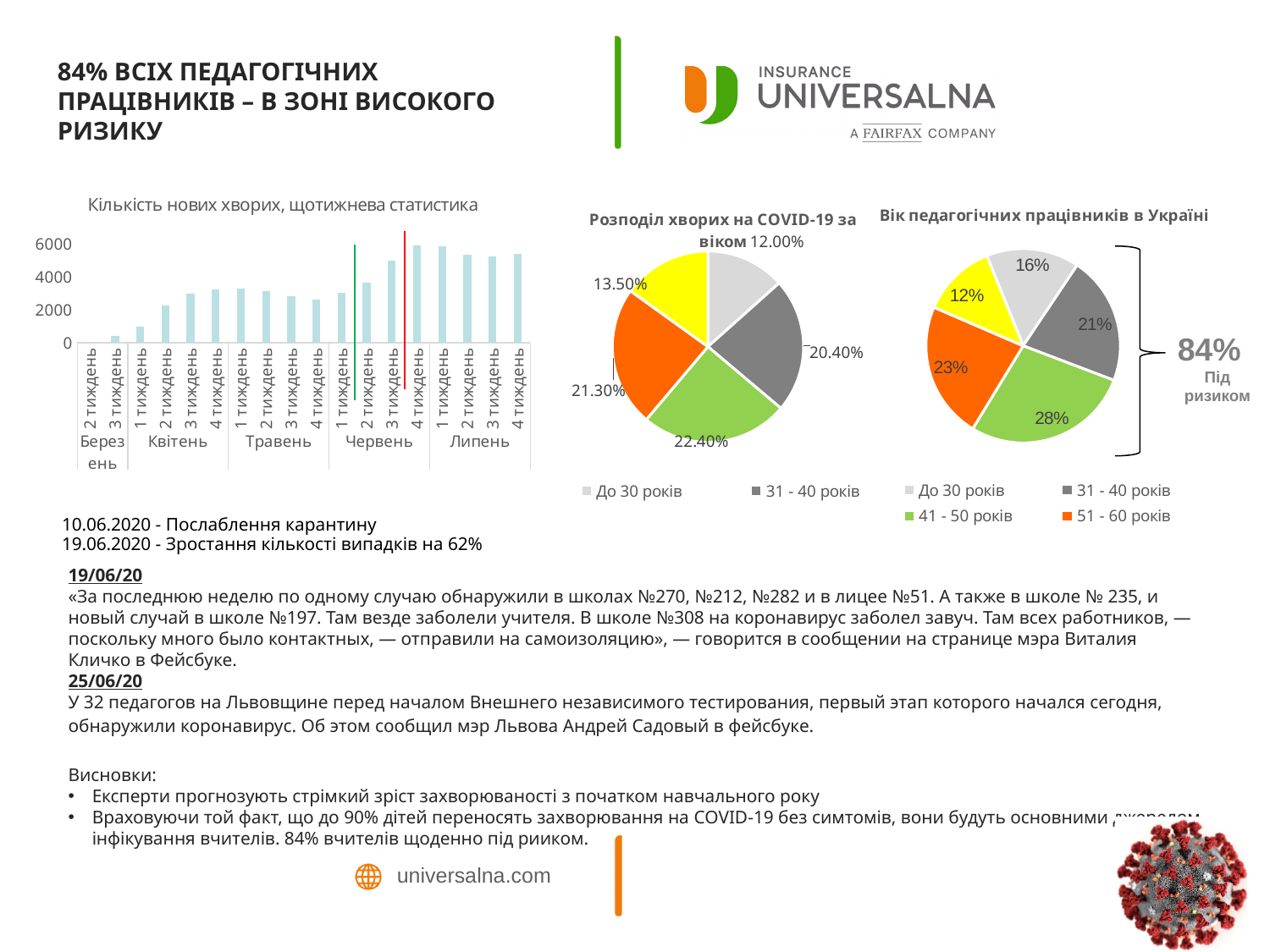
In the pie chart "Вік педагогічних працівників в Україні", what is the share for 41 - 50 років? 28% What kind of chart is the chart titled "Кількість нових хворих, щотижнева статистика"? bar chart In the chart "Кількість нових хворих, щотижнева статистика", is the value for 2 тиждень of Березень greater or less than 2000? less In the chart "Кількість нових хворих, щотижнева статистика", do the values generally rise or fall from Березень to Червень? rise In the pie chart "Вік педагогічних працівників в Україні", which age group has the largest share? 41 - 50 років How many entries does the legend of the pie chart "Вік педагогічних працівників в Україні" list? 4 In the pie chart "Розподіл хворих на COVID-19 за віком", what is the share for 31 - 40 років? 20.40% How many bars are plotted in the chart "Кількість нових хворих, щотижнева статистика"? 18 In the chart "Кількість нових хворих, щотижнева статистика", is the value for 4 тиждень of Червень greater or less than 4000? greater In the pie chart "Розподіл хворих на COVID-19 за віком", what is the share for До 30 років? 12.00% In the pie chart "Вік педагогічних працівників в Україні", what is the difference between the shares for 41 - 50 років and До 30 років? 12 percentage points In the pie chart "Розподіл хворих на COVID-19 за віком", what is the largest share shown? 22.40%